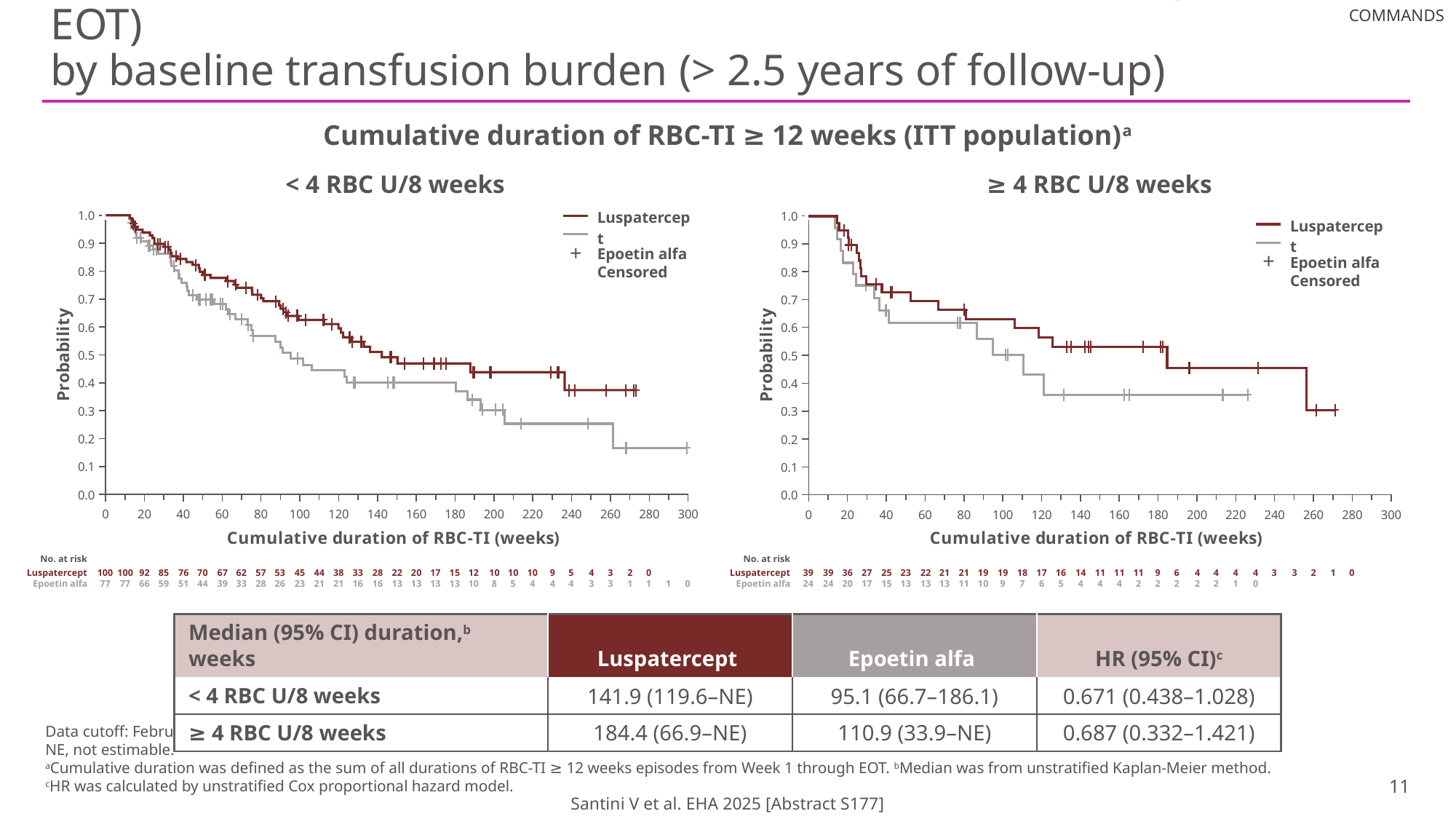
In the '≥ 4 RBC U/8 weeks' chart, is the Epoetin alfa probability at 150 weeks greater or less than 0.5? less In the '< 4 RBC U/8 weeks' chart, does the probability rise or fall as cumulative duration increases? fall In the '< 4 RBC U/8 weeks' chart, is the Luspatercept probability at 100 weeks greater or less than 0.5? greater What kind of chart is used for the '< 4 RBC U/8 weeks' panel? line chart According to the table, what is the median (95% CI) duration in weeks for Luspatercept in the < 4 RBC U/8 weeks group? 141.9 (119.6–NE) In the '< 4 RBC U/8 weeks' chart, which curve is higher at 100 weeks, Luspatercept or Epoetin alfa? Luspatercept In the '< 4 RBC U/8 weeks' chart, how many Luspatercept patients are at risk at week 0? 100 What is the x-axis label of the '≥ 4 RBC U/8 weeks' chart? Cumulative duration of RBC-TI (weeks) According to the table, what is the HR (95% CI) for the ≥ 4 RBC U/8 weeks group? 0.687 (0.332–1.421) In the '≥ 4 RBC U/8 weeks' chart, how many Epoetin alfa patients are at risk at week 0? 24 How many treatment groups are plotted in the '≥ 4 RBC U/8 weeks' chart? 2 In the '≥ 4 RBC U/8 weeks' chart, is the Luspatercept probability at 260 weeks greater or less than 0.4? less